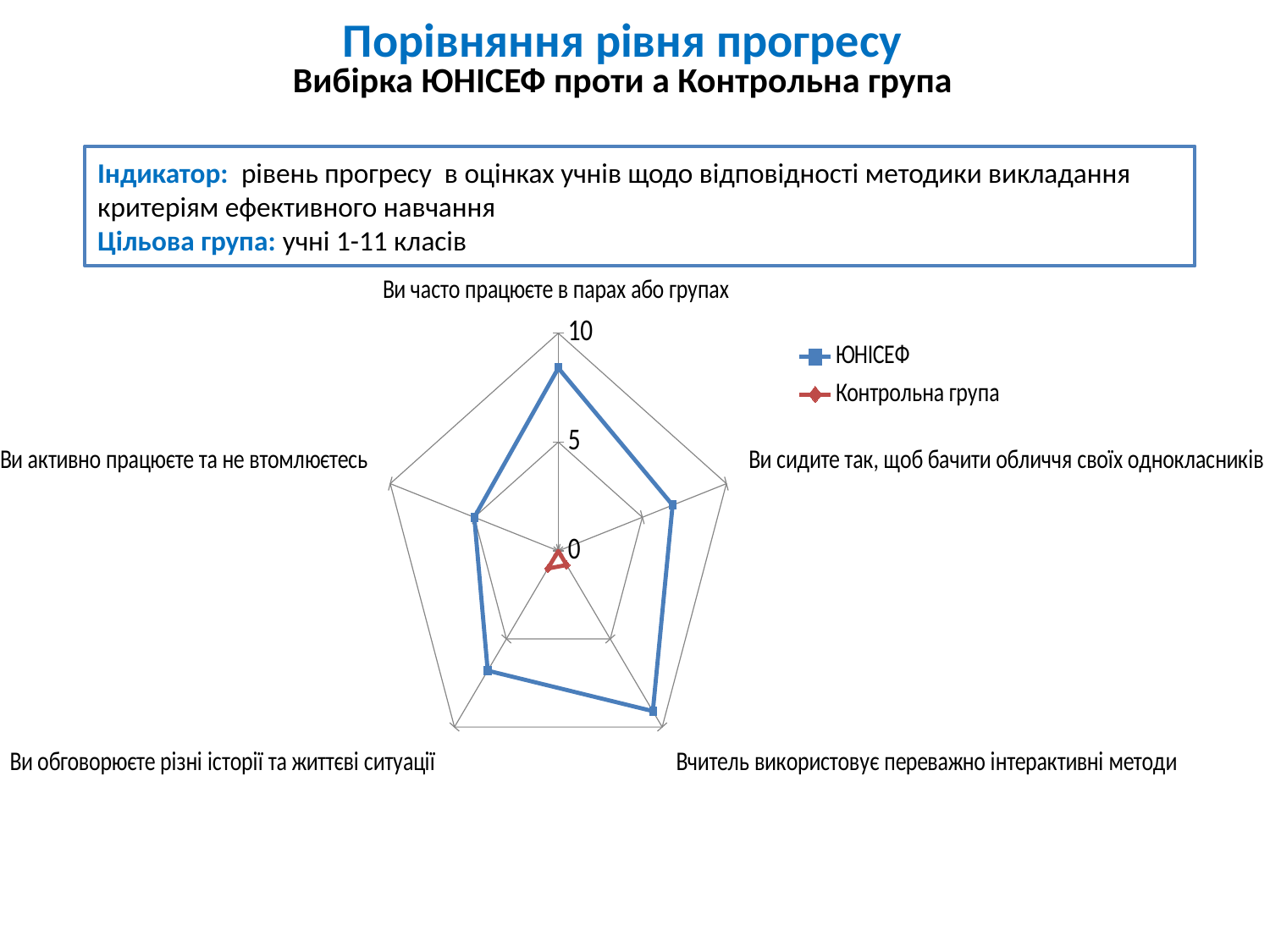
How many series does the legend list? 2 Is the Контрольна група value for "Вчитель використовує переважно інтерактивні методи" greater or less than 5? less Is the ЮНІСЕФ value for "Вчитель використовує переважно інтерактивні методи" greater or less than 5? greater How many categories (axes) does the radar chart have? 5 What is the maximum value shown on the radar chart's axis scale? 10 For the ЮНІСЕФ series, which is larger: the value for "Вчитель використовує переважно інтерактивні методи" or for "Ви активно працюєте та не втомлюєтесь"? Вчитель використовує переважно інтерактивні методи Is the Контрольна група value for "Ви часто працюєте в парах або групах" greater or less than 5? less Which series is drawn in red? Контрольна група Which series is drawn in blue? ЮНІСЕФ For "Ви обговорюєте різні історії та життєві ситуації", which series has the larger value, ЮНІСЕФ or Контрольна група? ЮНІСЕФ What kind of chart is shown on the slide? radar chart